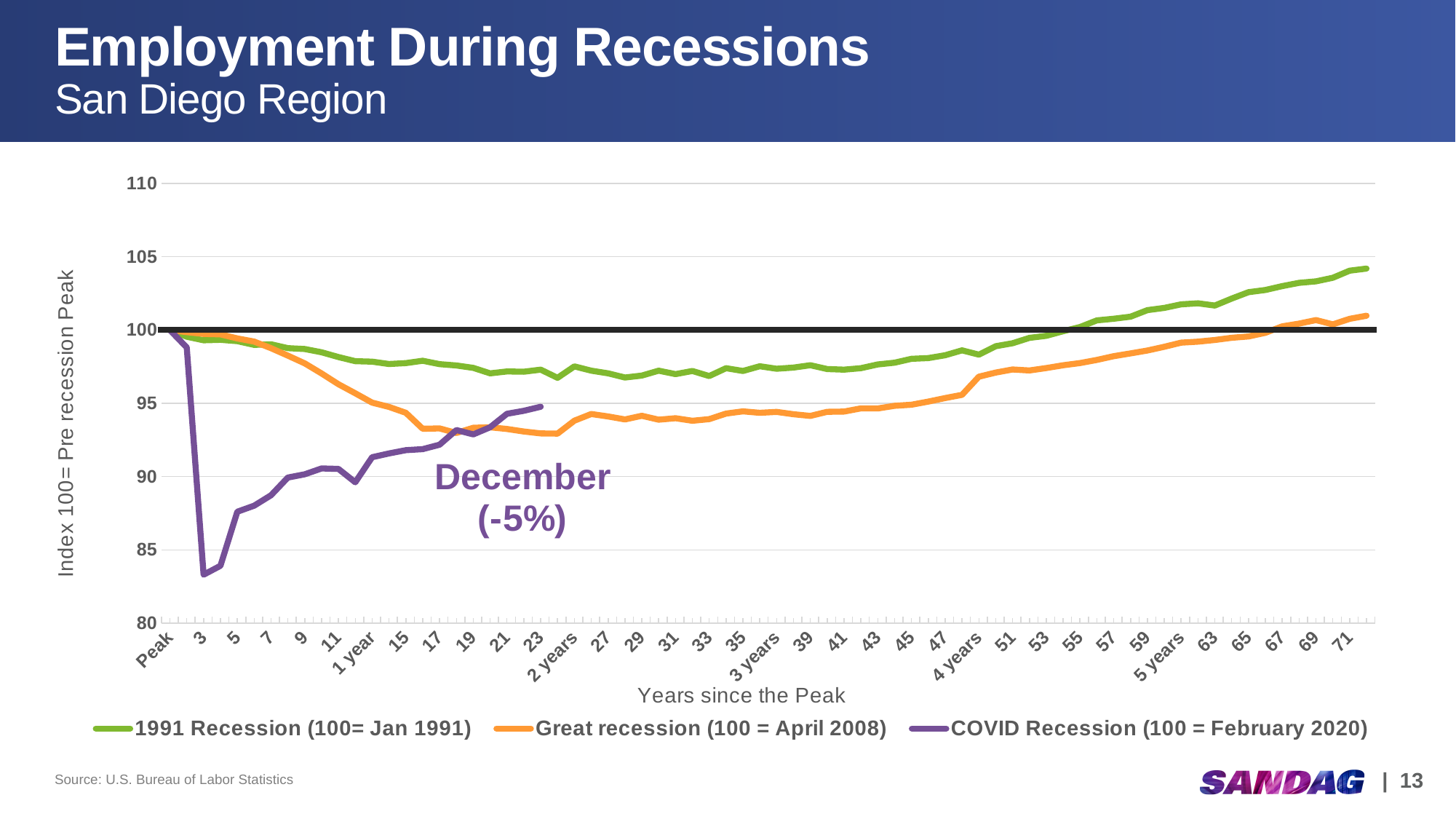
Which series has the highest value at the right end of the chart (month 71)? 1991 Recession (100= Jan 1991) Which series drops to the lowest index value on the chart? COVID Recession (100 = February 2020) What is the title of the chart on the slide? Employment During Recessions At 1 year since the peak, which series is higher: the 1991 Recession or the COVID Recession? 1991 Recession Does the COVID Recession series rise or fall between month 3 and month 23? rise What kind of chart is shown on the slide? line chart How many series does the legend list? 3 What percentage change does the annotation give for December in the COVID Recession series? -5% Is the value for the 1991 Recession series at month 71 greater or less than 100? greater Is the value for the Great recession series at 2 years greater or less than 95? less What is the label of the x axis? Years since the Peak Is the lowest value of the COVID Recession series greater or less than 85? less